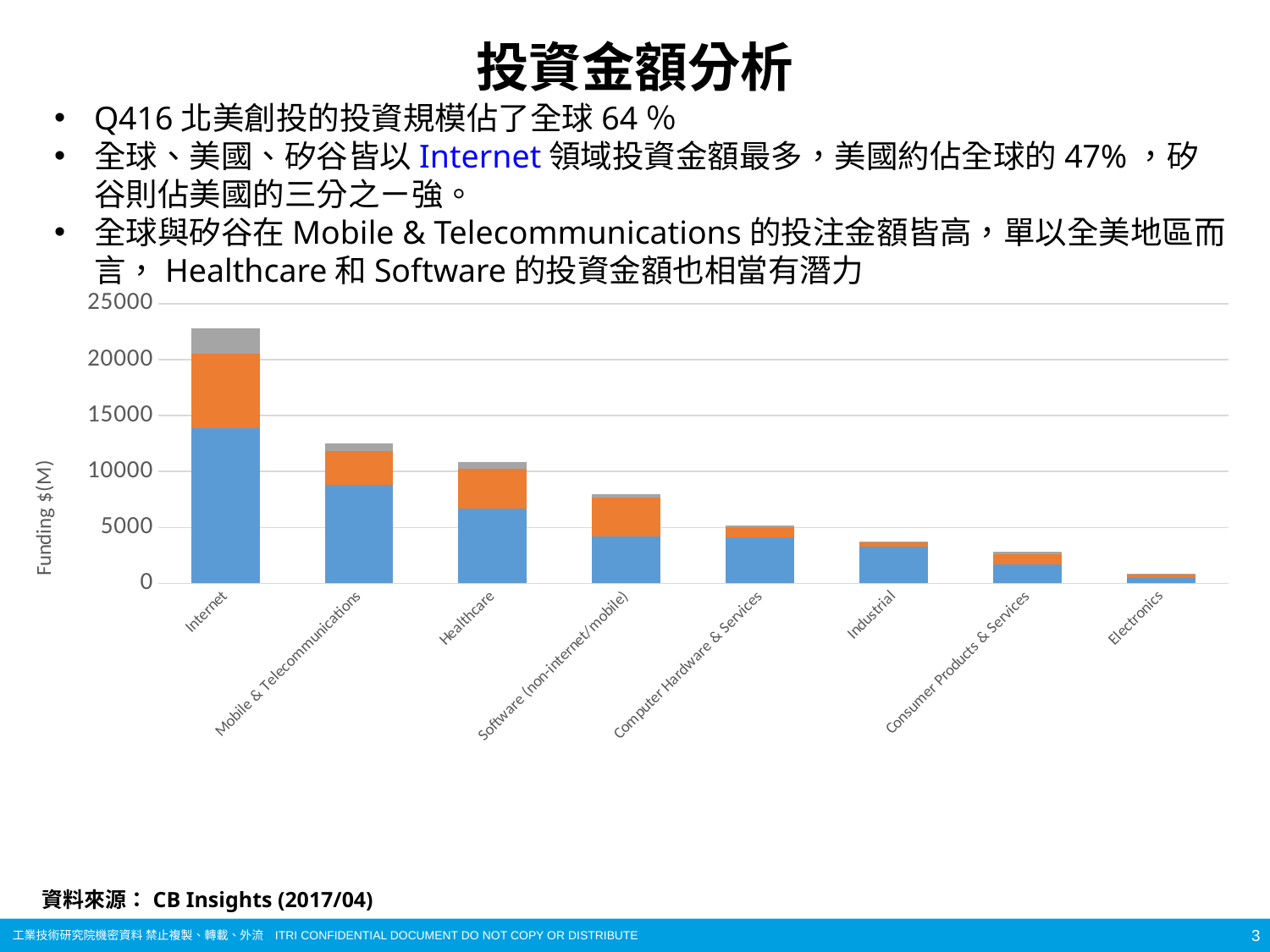
What kind of chart is shown on the slide? stacked bar chart Is the total stacked value for Healthcare greater or less than 10000? greater Do the stacked bar totals rise or fall moving from left to right along the x axis? fall Is the total stacked value for Internet greater or less than 20000? greater Is the total stacked value for Industrial greater or less than 5000? less Which category has the shortest stacked bar? Electronics What is the label on the y axis of the chart? Funding $(M) How many categories are shown on the x axis of the chart? 8 Which has the larger stacked bar, Consumer Products & Services or Computer Hardware & Services? Computer Hardware & Services Which category has the tallest stacked bar? Internet Which has the larger stacked bar, Healthcare or Software (non-internet/mobile)? Healthcare